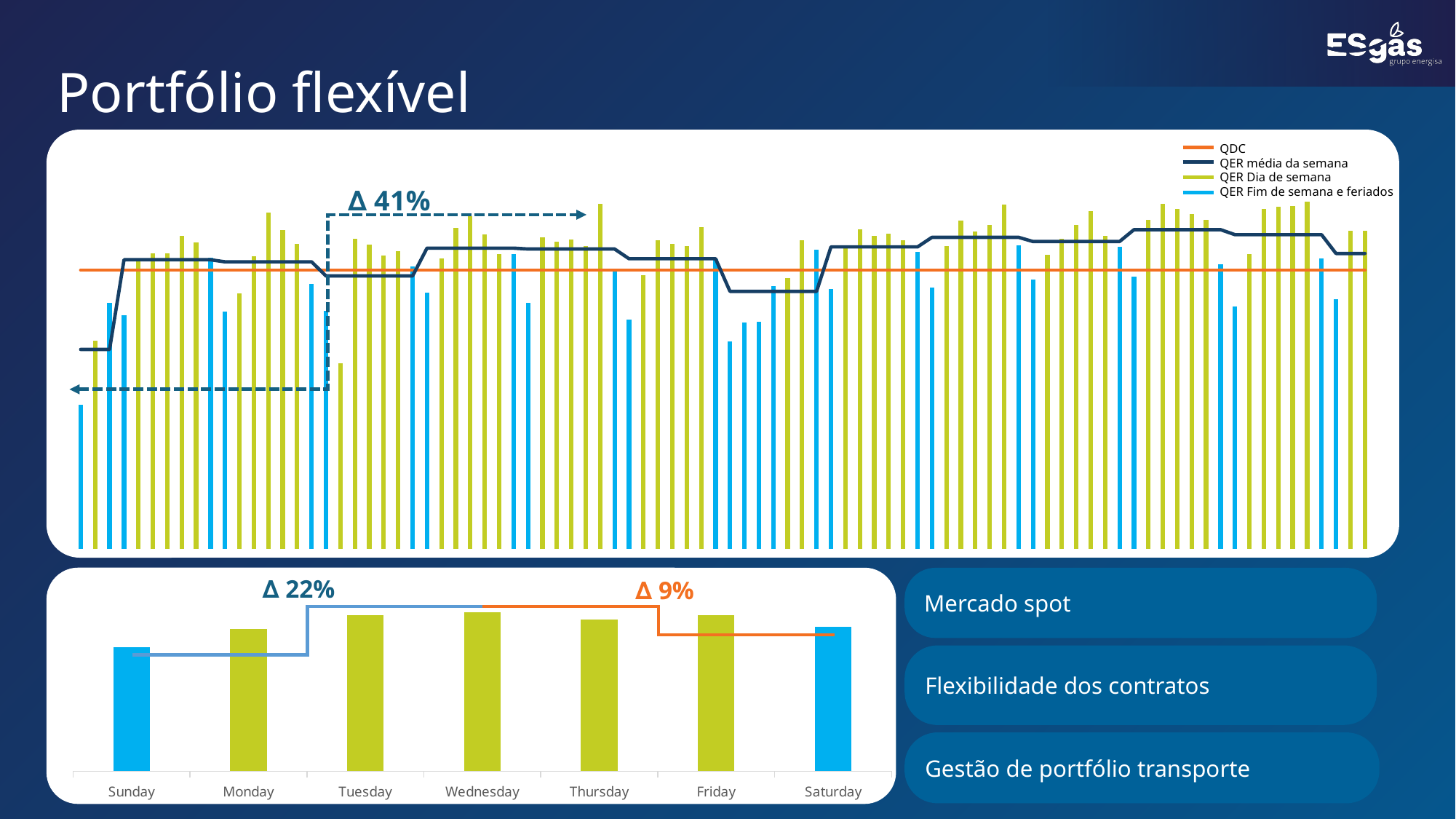
In the top chart, which legend entry corresponds to the light blue bars? QER Fim de semana e feriados In the bottom chart, do the bars rise or fall from Sunday to Tuesday? rise In the top chart, which legend entry is shown in orange? QDC In the bottom chart, which bar is taller, Sunday or Monday? Monday What kind of chart is the bottom chart? bar chart In the bottom chart, what percentage difference is annotated between the Sunday level and the Tuesday/Wednesday level? Δ 22% In the bottom chart, which day has the lowest bar? Sunday In the bottom chart, how many days of the week are shown on the x axis? 7 In the top chart, how many series does the legend list? 4 In the bottom chart, which bar is taller, Thursday or Saturday? Thursday